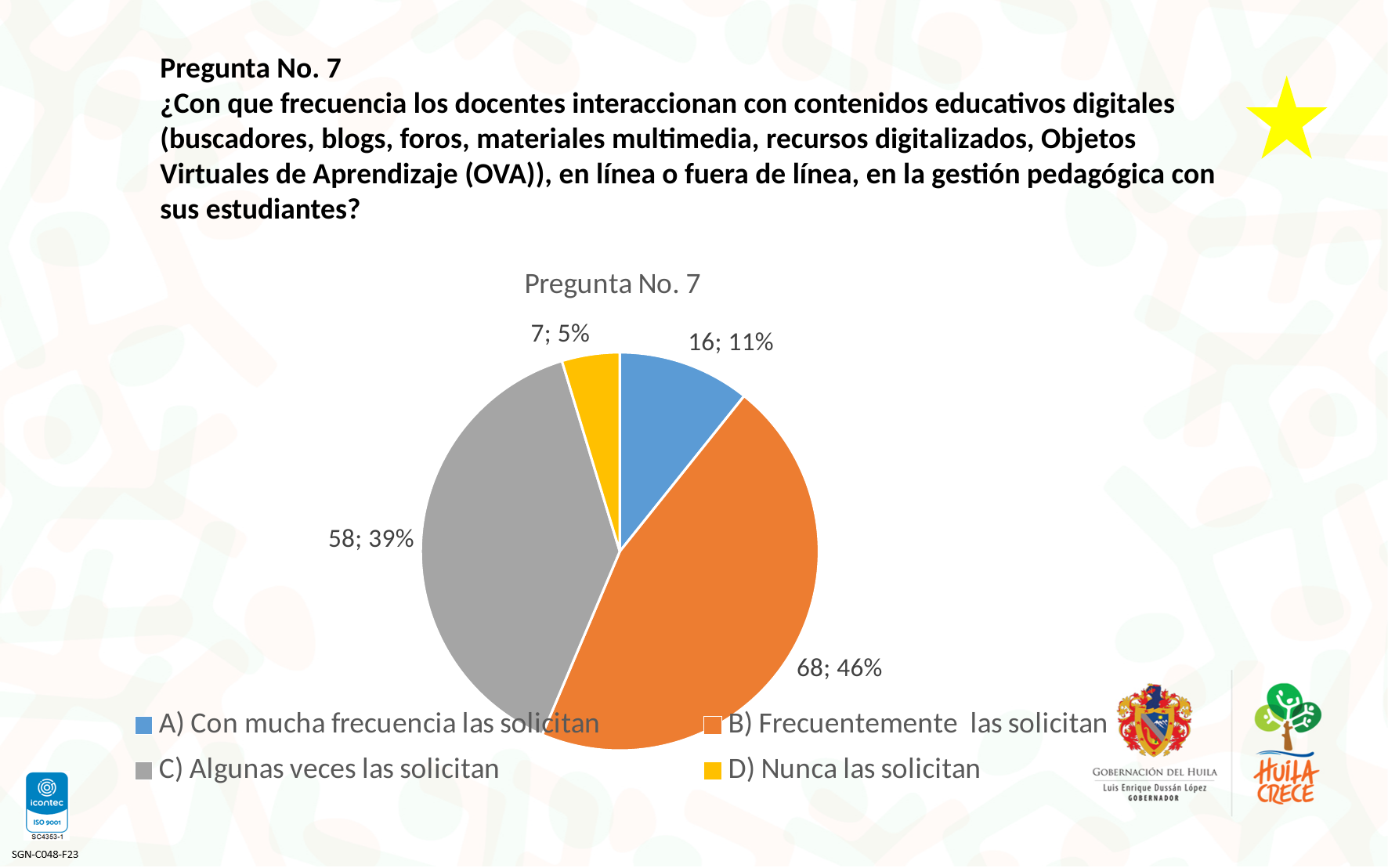
How many slices does the pie chart have? 4 What is the chart's title? Pregunta No. 7 What is the difference in count between 'B) Frecuentemente las solicitan' and 'C) Algunas veces las solicitan'? 10 What percentage share does 'C) Algunas veces las solicitan' have? 39% Which category has the smallest slice? D) Nunca las solicitan Which is larger: the count for 'A) Con mucha frecuencia las solicitan' or for 'D) Nunca las solicitan'? A) Con mucha frecuencia las solicitan What percentage share does 'D) Nunca las solicitan' have? 5% What kind of chart is shown on the slide? pie chart What is the count for 'B) Frecuentemente las solicitan'? 68 What colour is the slice for 'C) Algunas veces las solicitan'? grey Which category has the largest slice? B) Frecuentemente las solicitan What is the count for 'A) Con mucha frecuencia las solicitan'? 16